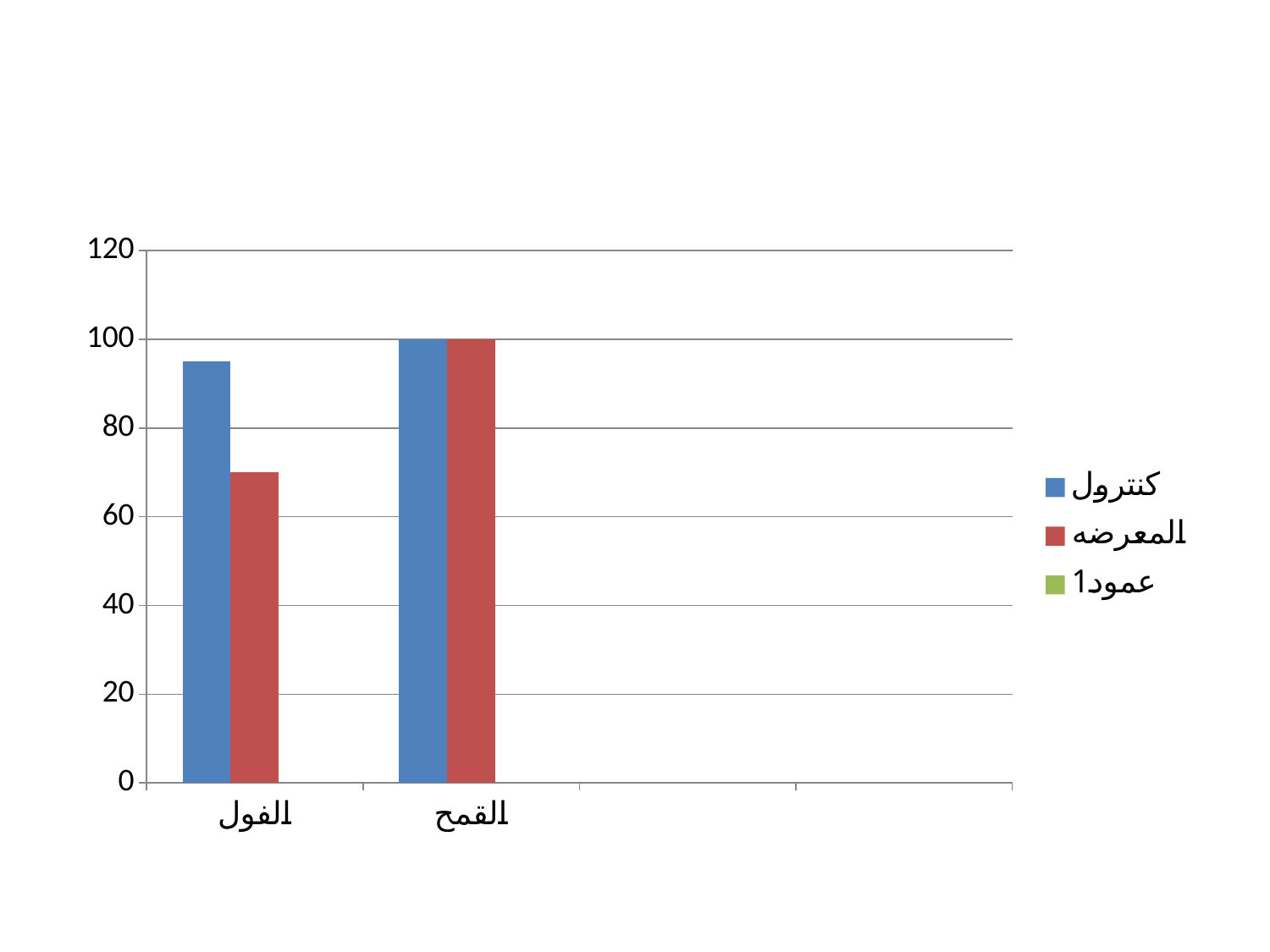
What is the value of المعرضه for القمح? 100 What kind of chart is shown on the slide? bar chart Is the value of المعرضه for الفول greater or less than 60? greater Which category has the lowest value for the المعرضه series? الفول Which category has the highest value for the المعرضه series? القمح Is the value of المعرضه for الفول greater or less than 80? less For الفول, which series has the larger value, كنترول or المعرضه? كنترول What is the value of كنترول for القمح? 100 How many series does the legend list? 3 What colour represents the كنترول series in the legend? blue Is the value of كنترول for الفول greater or less than 80? greater How many categories are shown on the x axis? 2